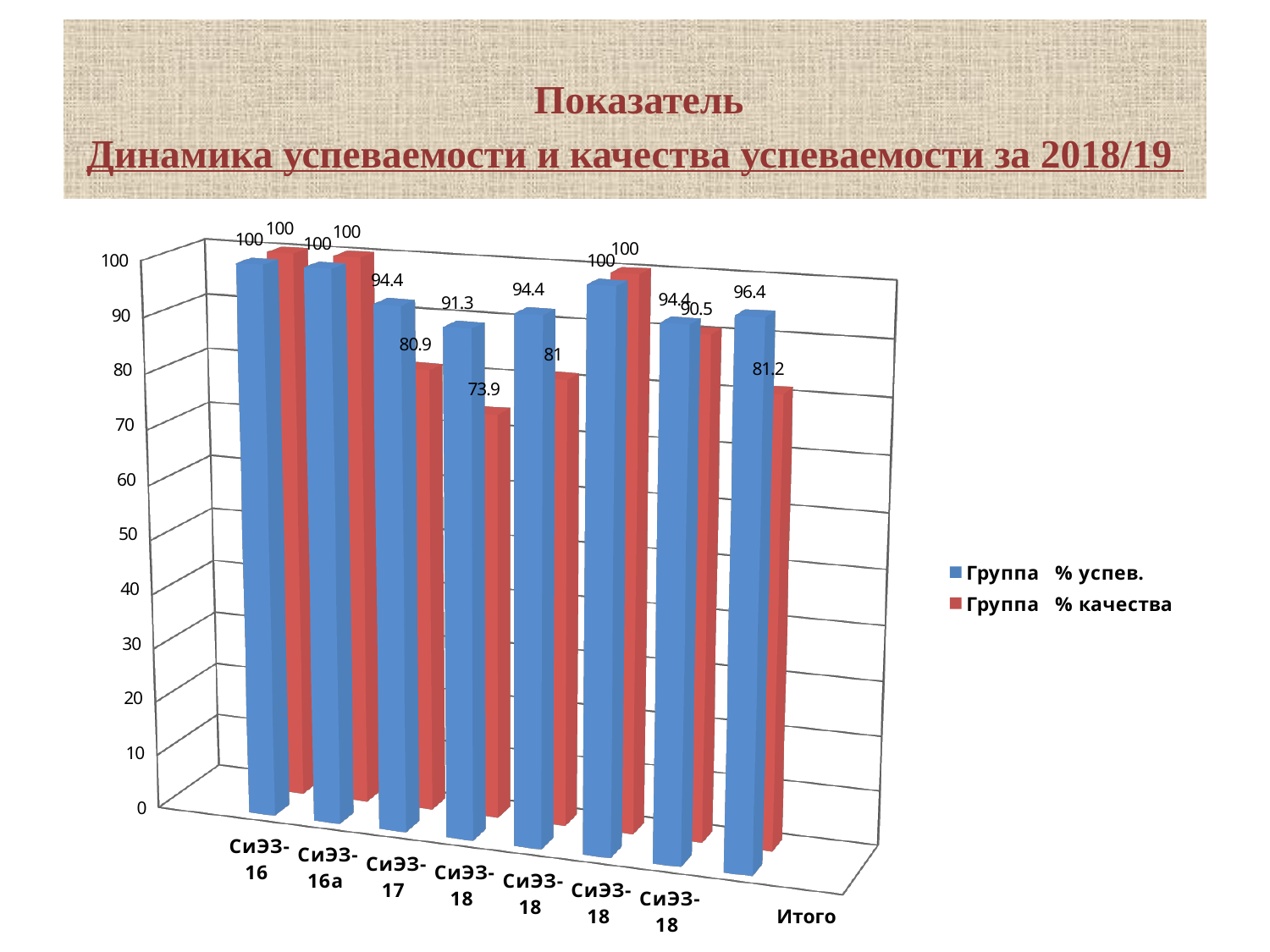
What is the value of Группа % успев. for СиЭЗ-16а? 100 What is the difference between Группа % успев. and Группа % качества for СиЭЗ-17? 13.5 How many series does the legend list? 2 What is the difference between Группа % успев. and Группа % качества for Итого? 15.2 How many categories are shown on the x axis of the chart? 8 What is the value of Группа % качества for Итого? 81.2 What kind of chart is shown on the slide? Bar chart What is the value of Группа % качества for СиЭЗ-17? 80.9 What is the lowest value shown for the Группа % качества series? 73.9 Which has the higher Группа % успев. value: СиЭЗ-17 or Итого? Итого What is the value of Группа % успев. for СиЭЗ-17? 94.4 What is the value of Группа % успев. for Итого? 96.4